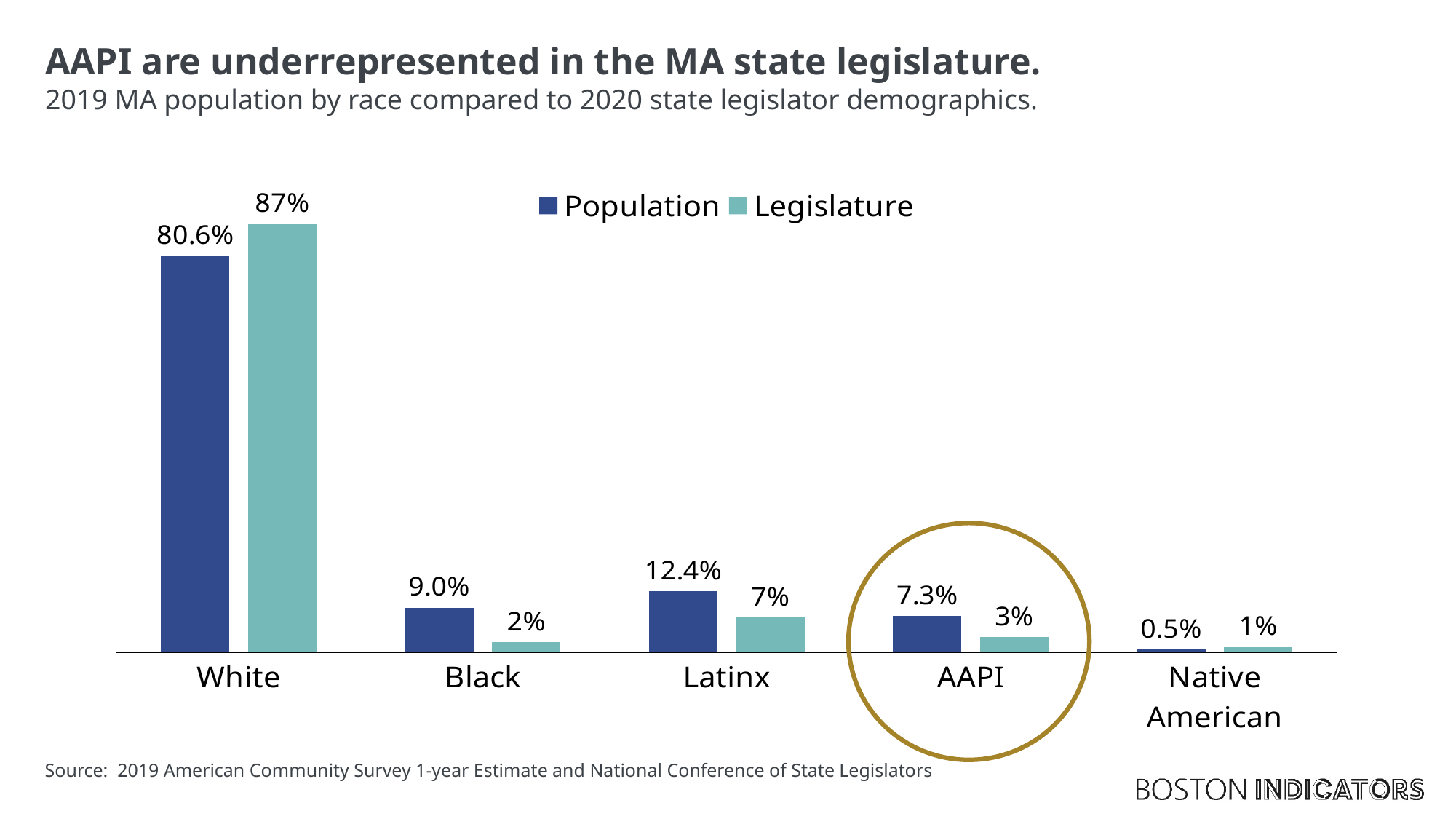
What is the Population value for AAPI? 7.3% What is the Legislature value for Black? 2% What is the Population value for Latinx? 12.4% Which category has the highest Population value? White What is the Legislature value for Native American? 1% What kind of chart is shown on the slide? Bar chart Which category is highlighted with a circle on the chart? AAPI How many series does the legend list? 2 Which is larger for Latinx, the Population value or the Legislature value? Population Which category has the lowest Legislature value? Native American How many race categories are shown on the x axis? 5 What is the difference between the Population and Legislature values for AAPI? 4.3%